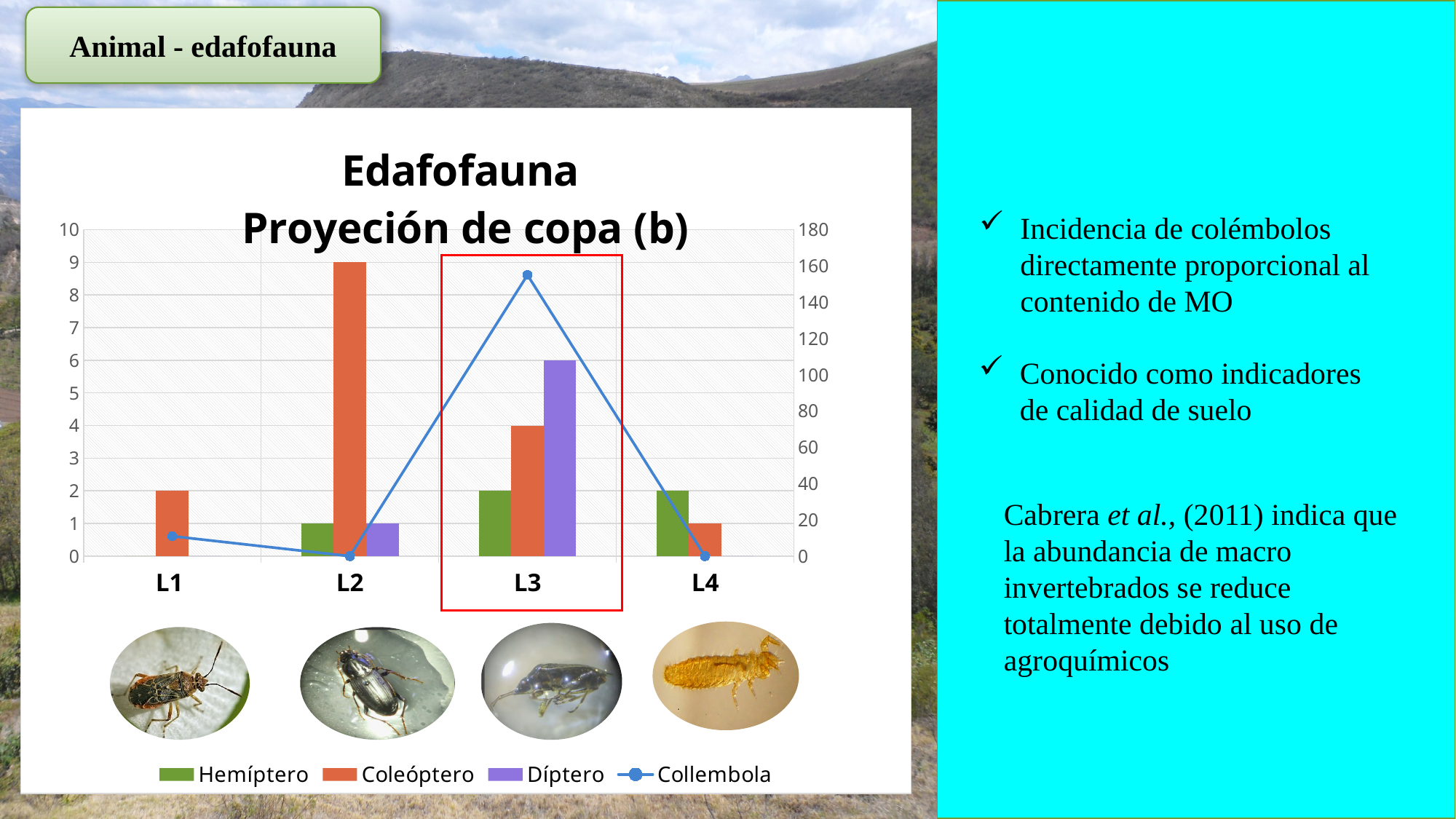
Which category has the highest Collembola value? L3 How many categories are shown on the x axis? 4 For L4, which is larger: Hemíptero or Coleóptero? Hemíptero Is the Collembola value for L3 greater or less than 140? greater What is the title of the chart? Edafofauna Proyeción de copa (b) How many series does the legend list? 4 What is the Díptero value for L3? 6 What is the Collembola value for L2? 0 What kind of chart is shown on the slide? A bar chart combined with a line What is the difference between the Díptero and Coleóptero values for L3? 2 Which category has the highest Coleóptero value? L2 What is the Coleóptero value for L2? 9